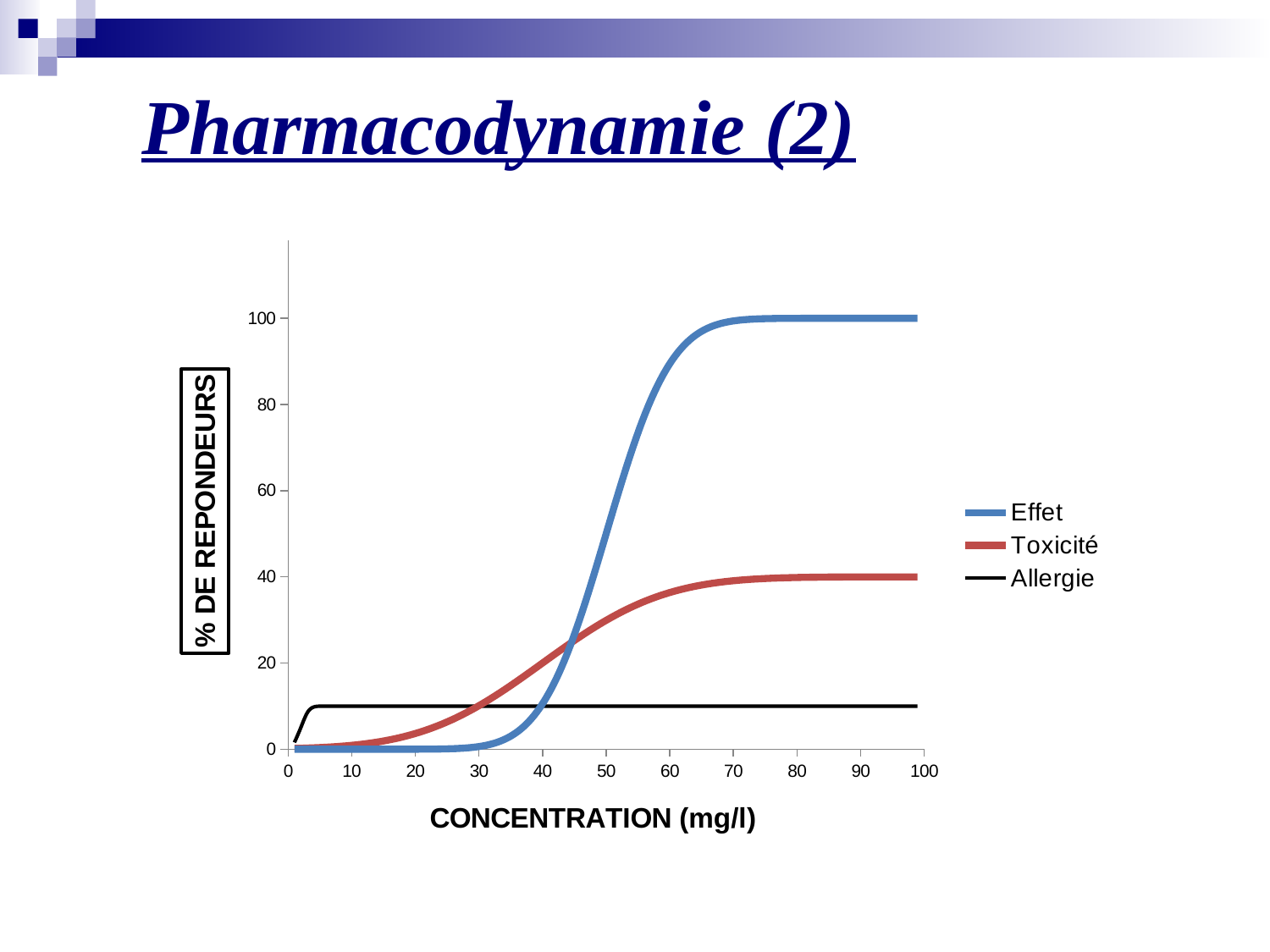
At what constant percentage of responders does the Allergie line sit across most of the concentration range? 10 At a concentration of 30 mg/l, which is higher: Effet or Toxicité? Toxicité At what percentage of responders does the Effet curve plateau at high concentrations? 100 What kind of chart is shown on the slide? line chart What are the three series named in the legend? Effet, Toxicité, Allergie How many series does the legend list? 3 Which series reaches the highest percentage of responders? Effet At a concentration of 80 mg/l, which is higher: Effet or Toxicité? Effet Is the value for Toxicité at 20 mg/l greater or less than 20? less Which series has the lowest percentage of responders at 100 mg/l? Allergie What is the title of the x axis? CONCENTRATION (mg/l) At what percentage of responders does the Toxicité curve plateau at high concentrations? 40